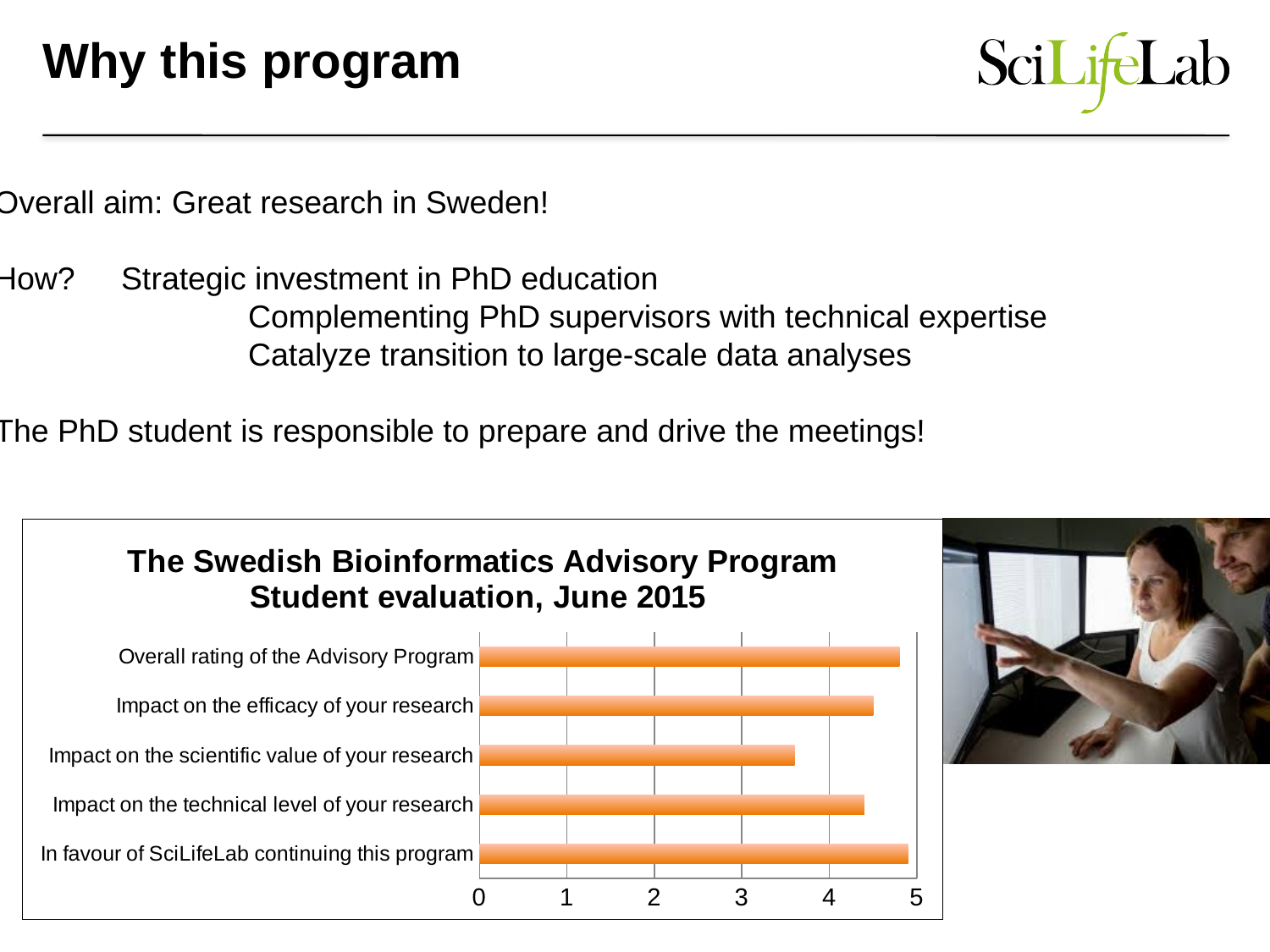
What is the title of the chart? The Swedish Bioinformatics Advisory Program Student evaluation, June 2015 Is the value for "Impact on the technical level of your research" greater or less than 4? greater Is the value for "In favour of SciLifeLab continuing this program" greater or less than 4? greater How many categories are plotted in the chart? 5 Is the value for "Overall rating of the Advisory Program" greater or less than 4? greater Which category has the lowest value in the chart? Impact on the scientific value of your research Which is larger: the value for "Impact on the efficacy of your research" or "Impact on the scientific value of your research"? Impact on the efficacy of your research Which is larger: the value for "In favour of SciLifeLab continuing this program" or "Impact on the scientific value of your research"? In favour of SciLifeLab continuing this program What kind of chart is shown on the slide? Bar chart What is the maximum value shown on the chart's horizontal axis? 5